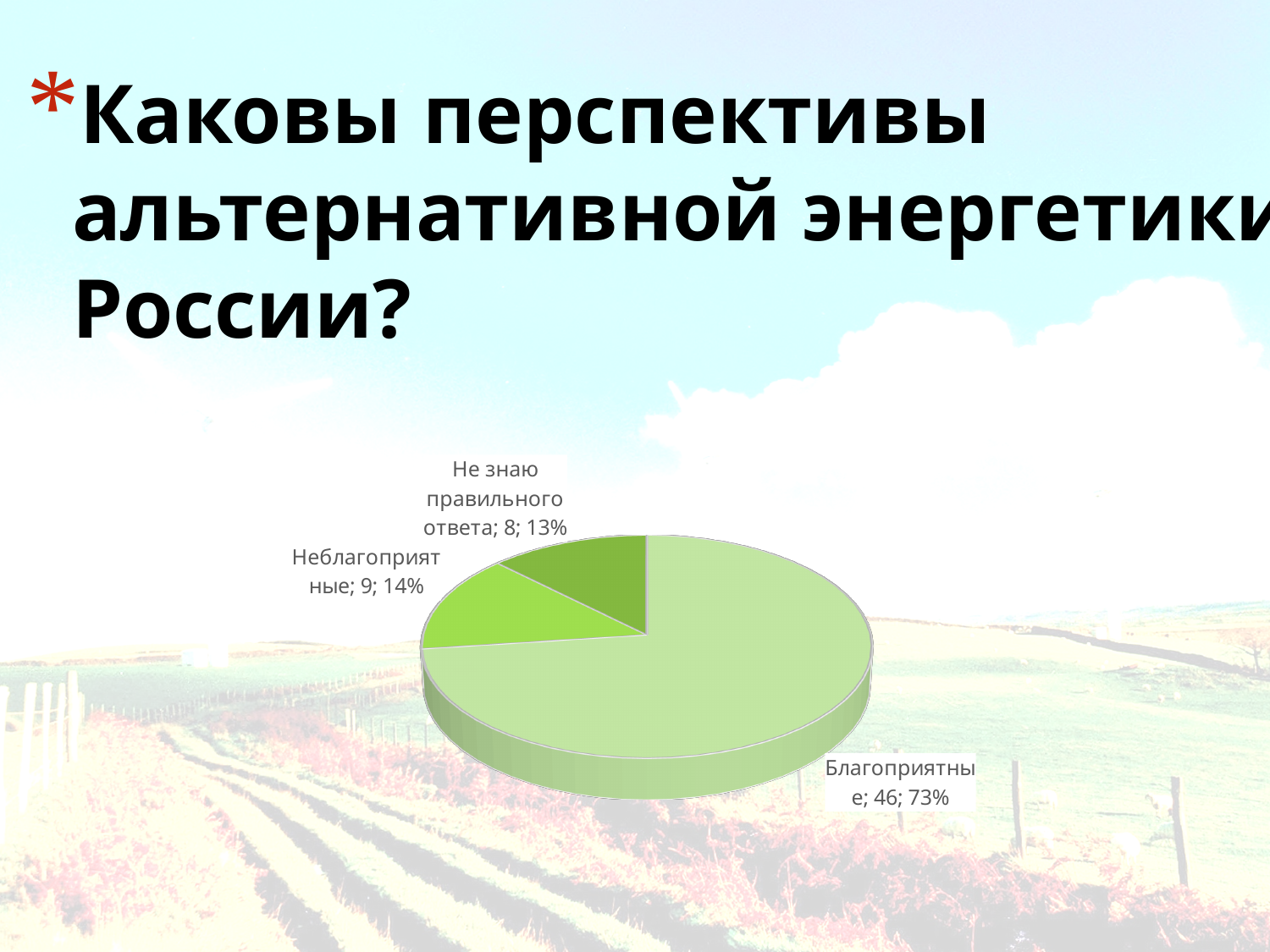
Which category has the smallest slice? Не знаю правильного ответа What is the difference between the values for Благоприятные and Неблагоприятные? 37 What kind of chart is shown on the slide? pie chart How many slices does the pie chart have? 3 Which is larger, the value for Благоприятные or the value for Неблагоприятные? Благоприятные What is the value for Благоприятные? 46 What share of the pie does Неблагоприятные take? 14% What is the value for Неблагоприятные? 9 What share of the pie does Не знаю правильного ответа take? 13% What share of the pie does Благоприятные take? 73% Which category has the largest slice? Благоприятные What is the value for Не знаю правильного ответа? 8